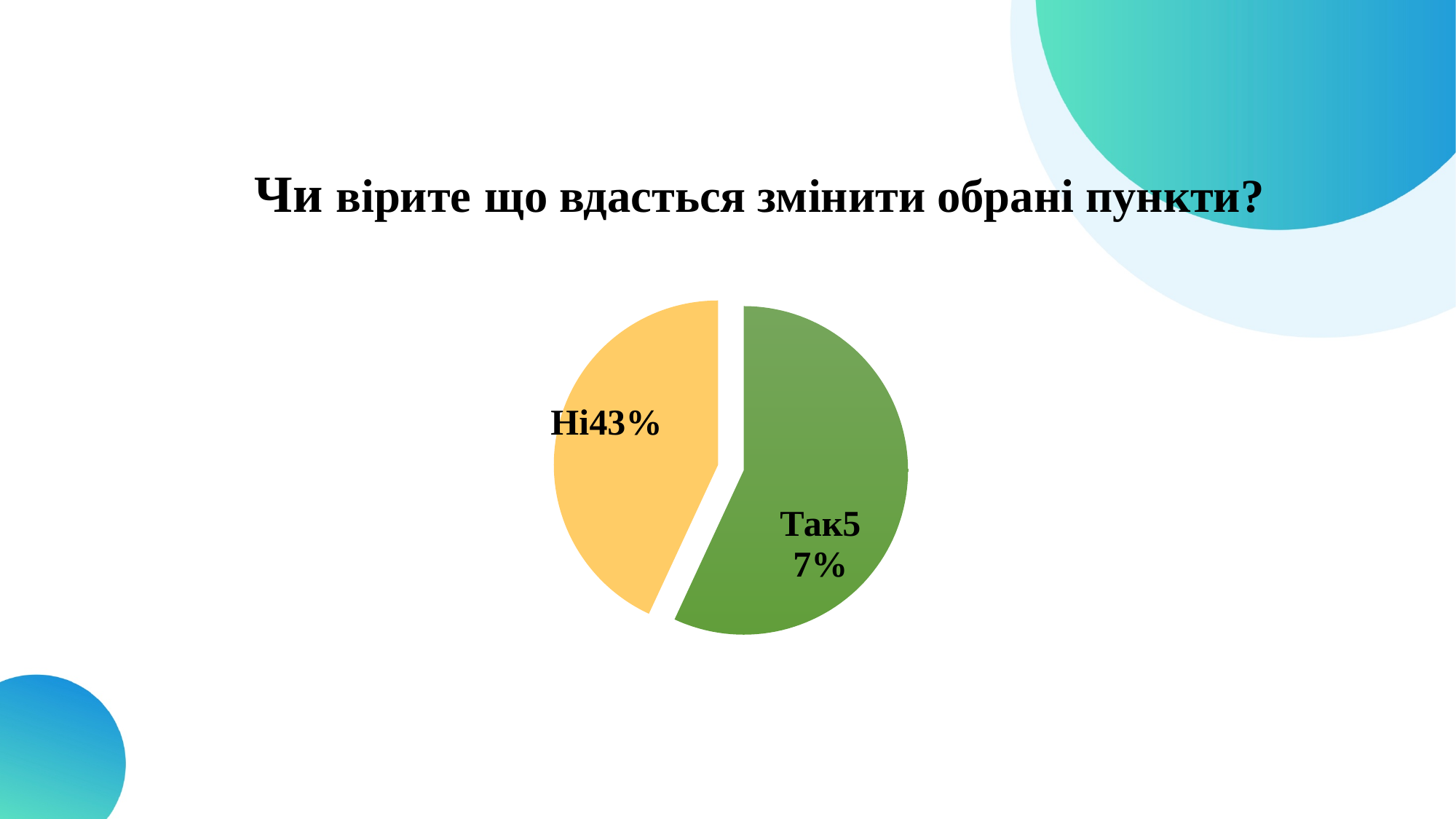
What kind of chart is shown on the slide? Pie chart Which answer has the smallest share of the pie? Ні What percentage of respondents answered "Так"? 57% What percentage of respondents answered "Ні"? 43% How many slices does the pie chart have? 2 Which is larger, the share for "Так" or the share for "Ні"? Так Is the share for "Ні" greater or less than 50%? less By how many percentage points does "Так" exceed "Ні"? 14 percentage points What is the title of the slide above the chart? Чи вірите що вдасться змінити обрані пункти? What share of the pie does the "Так" slice represent? 57% What colour is the "Так" slice of the pie chart? Green Which answer has the largest share of the pie? Так